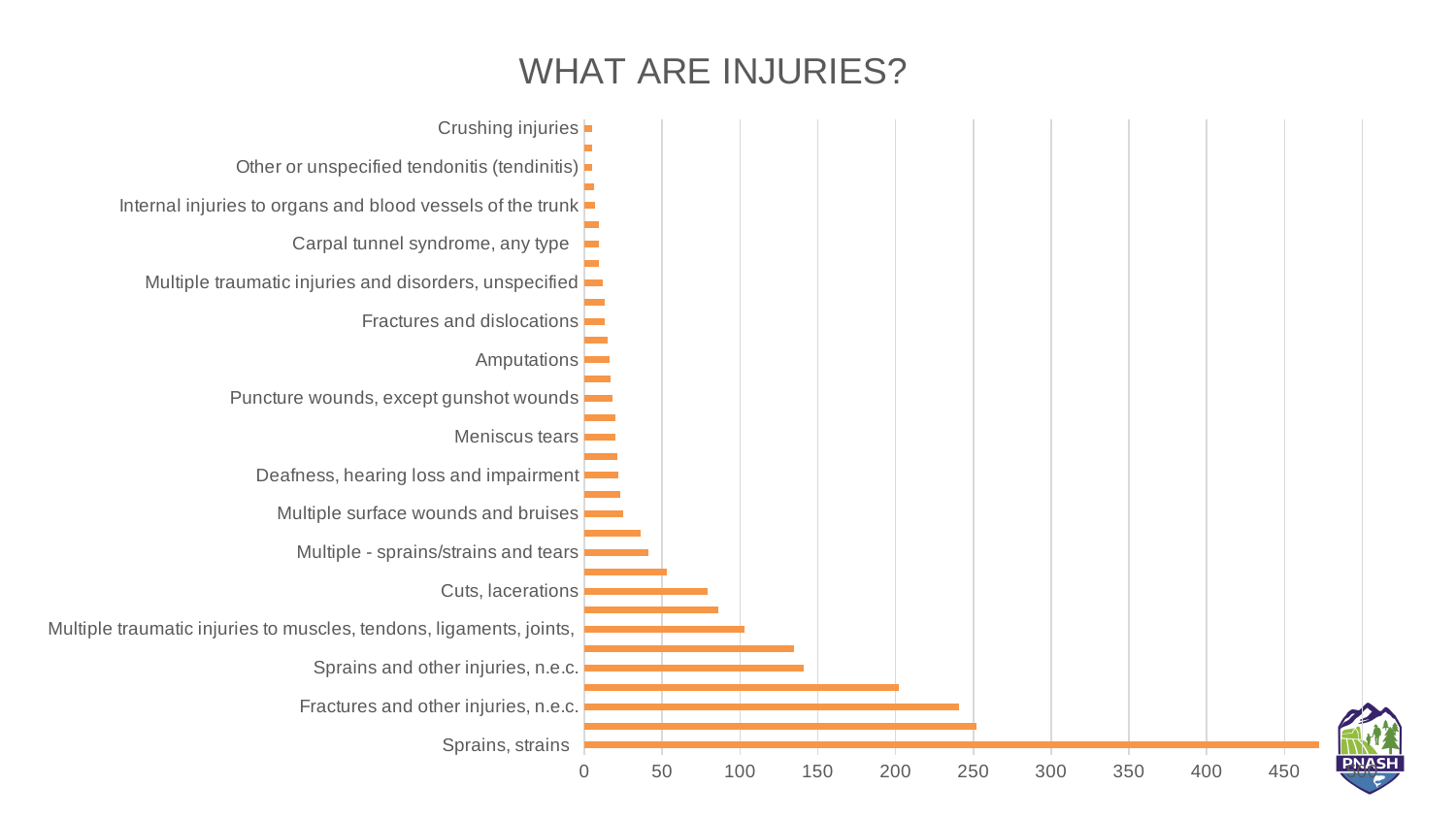
Which is larger, the value for Sprains, strains or the value for Sprains and other injuries, n.e.c.? Sprains, strains Is the value for Cuts, lacerations greater or less than 100? less Is the value for Fractures and other injuries, n.e.c. greater or less than 250? less What kind of chart is shown on the slide? bar chart What is the title of the chart? WHAT ARE INJURIES? Is the value for Multiple - sprains/strains and tears greater or less than 50? less Which injury category has the highest value? Sprains, strains Which is larger, the value for Cuts, lacerations or the value for Fractures and dislocations? Cuts, lacerations